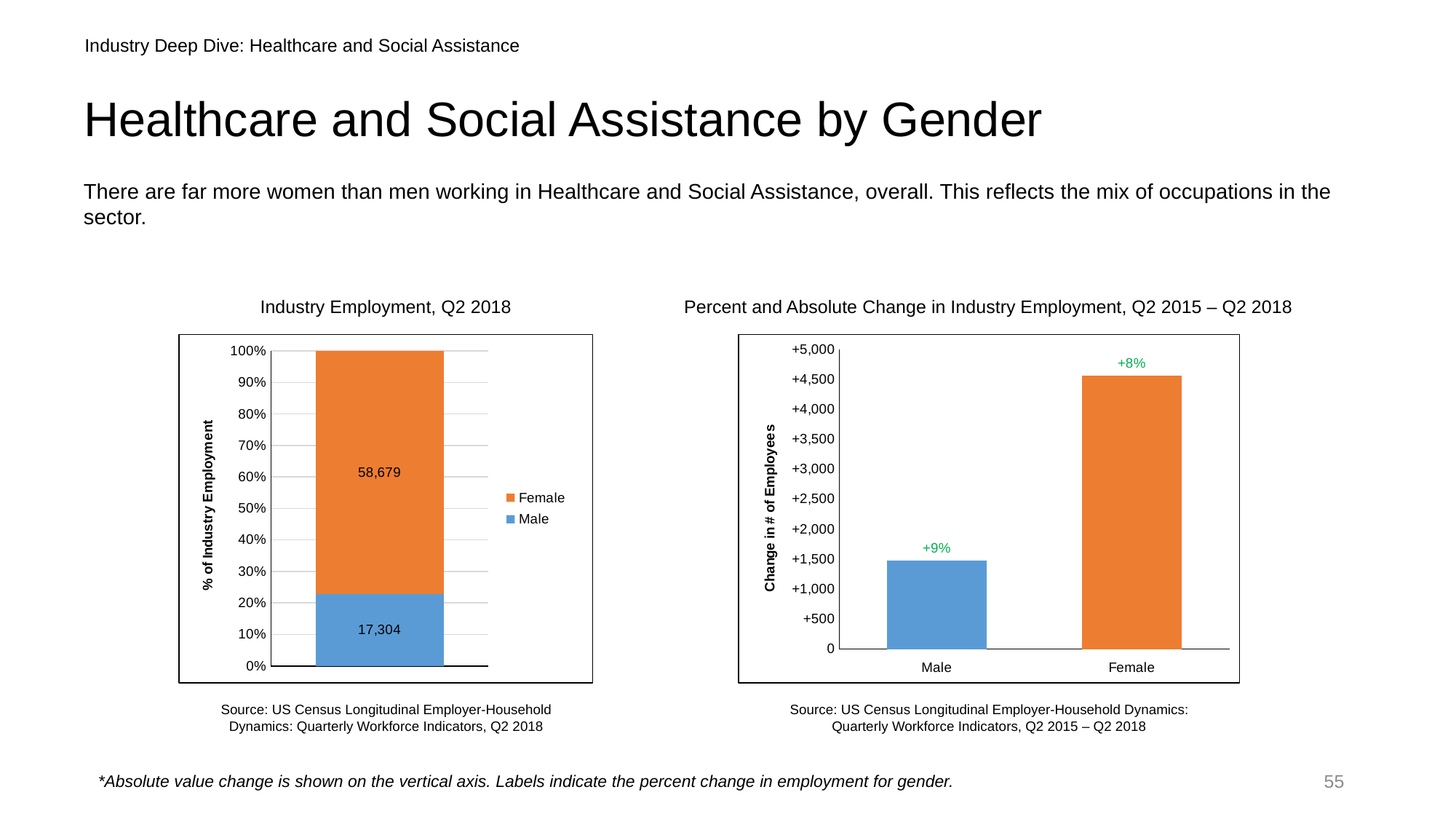
In the 'Industry Employment, Q2 2018' chart, what is the total of the stacked bar? 75,983 In the 'Industry Employment, Q2 2018' chart, what is the difference between the Female and Male values? 41,375 In the 'Industry Employment, Q2 2018' chart, what is the label on the vertical axis? % of Industry Employment In the 'Industry Employment, Q2 2018' chart, how many series does the legend list? 2 In the 'Industry Employment, Q2 2018' chart, which series has the larger value, Female or Male? Female In the 'Industry Employment, Q2 2018' chart, what is the value shown for Female? 58,679 In the 'Percent and Absolute Change in Industry Employment, Q2 2015 – Q2 2018' chart, is the bar for Male greater or less than +2,000? less In the 'Percent and Absolute Change in Industry Employment, Q2 2015 – Q2 2018' chart, what percent change label is shown for Male? +9% In the 'Industry Employment, Q2 2018' chart, what is the value shown for Male? 17,304 In the 'Percent and Absolute Change in Industry Employment, Q2 2015 – Q2 2018' chart, which category has the taller bar? Female In the 'Percent and Absolute Change in Industry Employment, Q2 2015 – Q2 2018' chart, what percent change label is shown for Female? +8% In the 'Percent and Absolute Change in Industry Employment, Q2 2015 – Q2 2018' chart, is the bar for Female greater or less than +4,000? greater